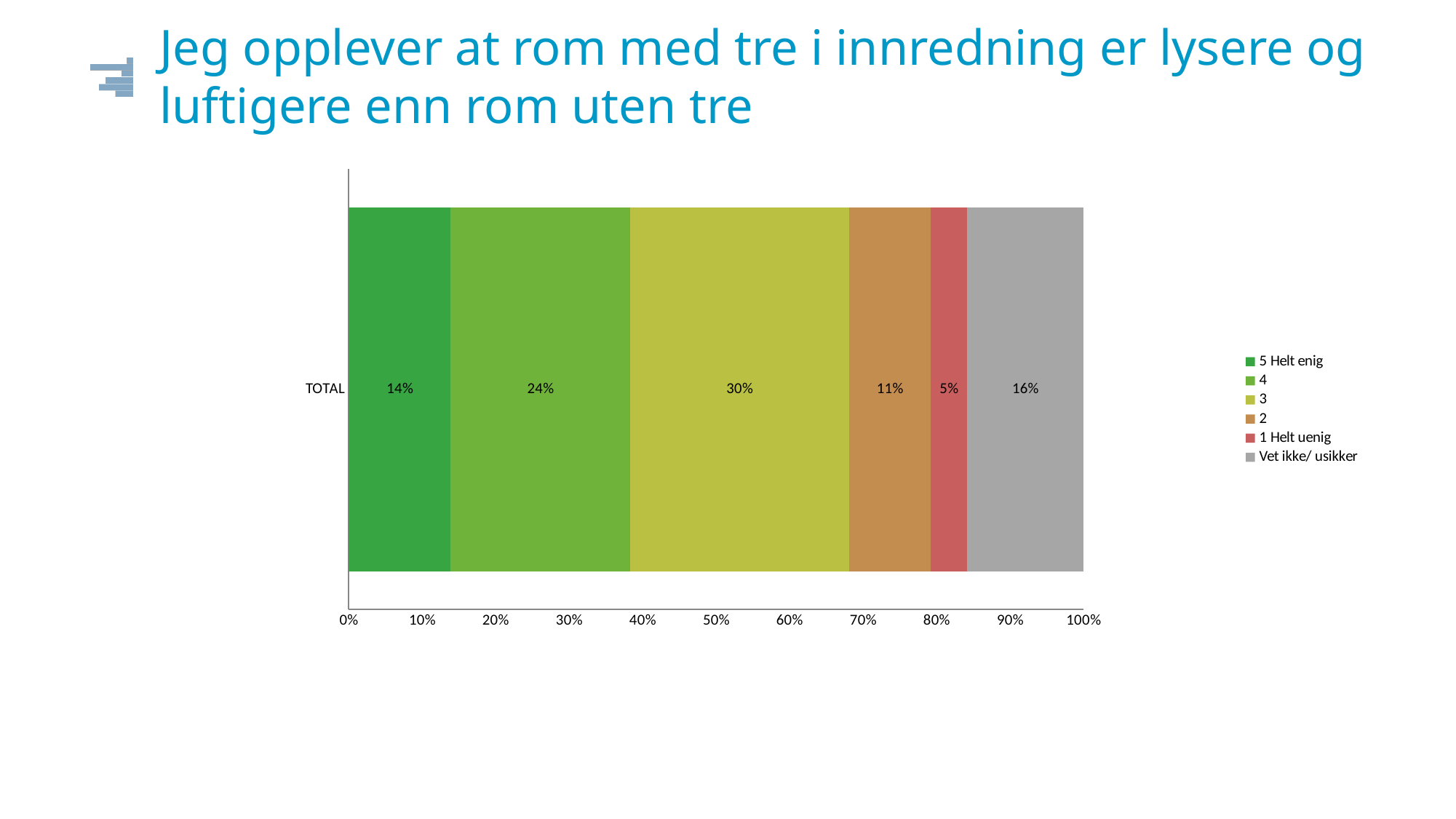
Which is larger, the share for "5 Helt enig" or the share for "Vet ikke/ usikker"? Vet ikke/ usikker How many series does the legend list? 6 What is the value for the "3" series in the TOTAL bar? 30% Which response category has the largest share in the TOTAL bar? 3 What is the label of the single category on the vertical axis? TOTAL What is the combined share of "5 Helt enig" and "4"? 38% What is the difference between the share for "4" and the share for "2"? 13% What share of respondents answered "Vet ikke/ usikker"? 16% What is the value for "1 Helt uenig"? 5% Which response category has the smallest share in the TOTAL bar? 1 Helt uenig What percentage of respondents answered "5 Helt enig"? 14% What kind of chart is shown on the slide? Stacked bar chart